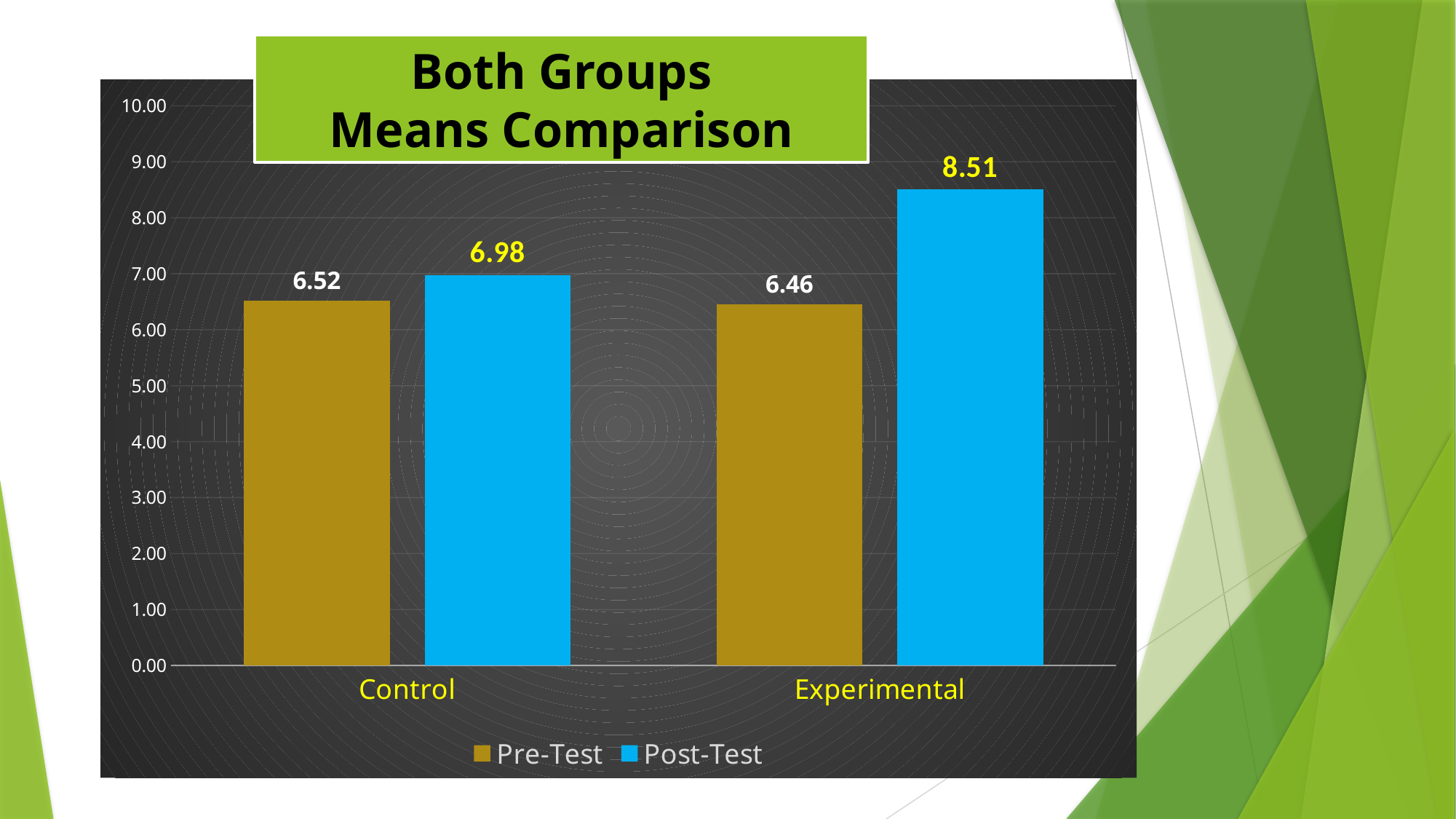
Which group has the lowest Pre-Test value? Experimental Which group has the highest Post-Test value? Experimental What is the Post-Test value for the Experimental group? 8.51 What is the Pre-Test value for the Control group? 6.52 What kind of chart is shown on the slide? Bar chart How many groups are shown on the x axis? 2 What is the Pre-Test value for the Experimental group? 6.46 What is the difference between the Post-Test and Pre-Test values for the Control group? 0.46 What is the Post-Test value for the Control group? 6.98 Which is larger, the Control Post-Test value or the Experimental Post-Test value? Experimental Post-Test What is the difference between the Post-Test and Pre-Test values for the Experimental group? 2.05 How many series does the legend list? 2